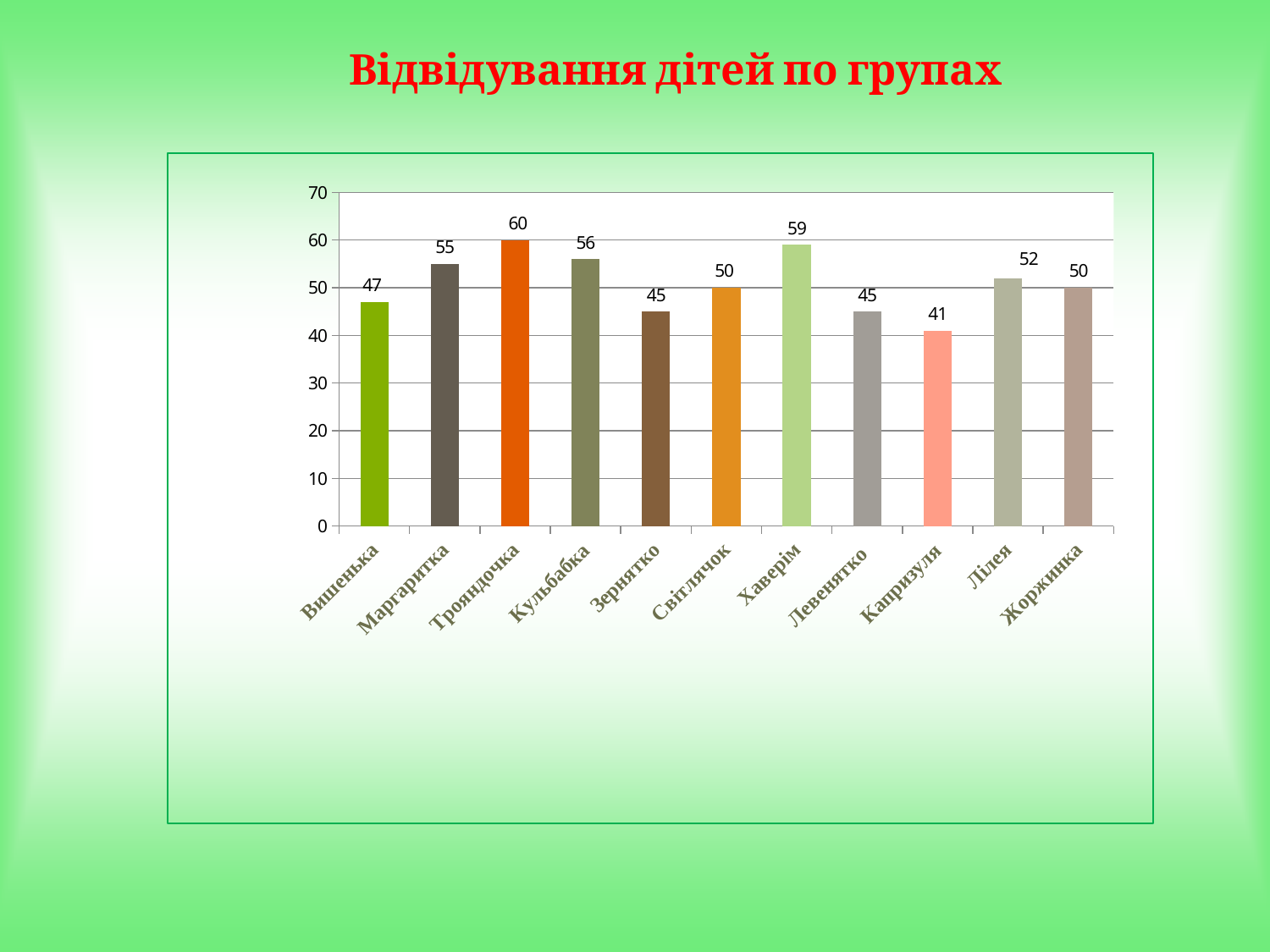
What is the difference between the values for Трояндочка and Капризуля? 19 What is the title of the slide? Відвідування дітей по групах What is the value for Хаверім? 59 How many groups are shown on the chart? 11 Which is larger, the value for Маргаритка or the value for Лілея? Маргаритка What kind of chart is shown on the slide? bar chart What is the value for Трояндочка? 60 Is the value for Зернятко greater or less than 50? less What is the value for Капризуля? 41 Which group has the highest value? Трояндочка Which group has the lowest value? Капризуля What is the difference between the values for Кульбабка and Вишенька? 9